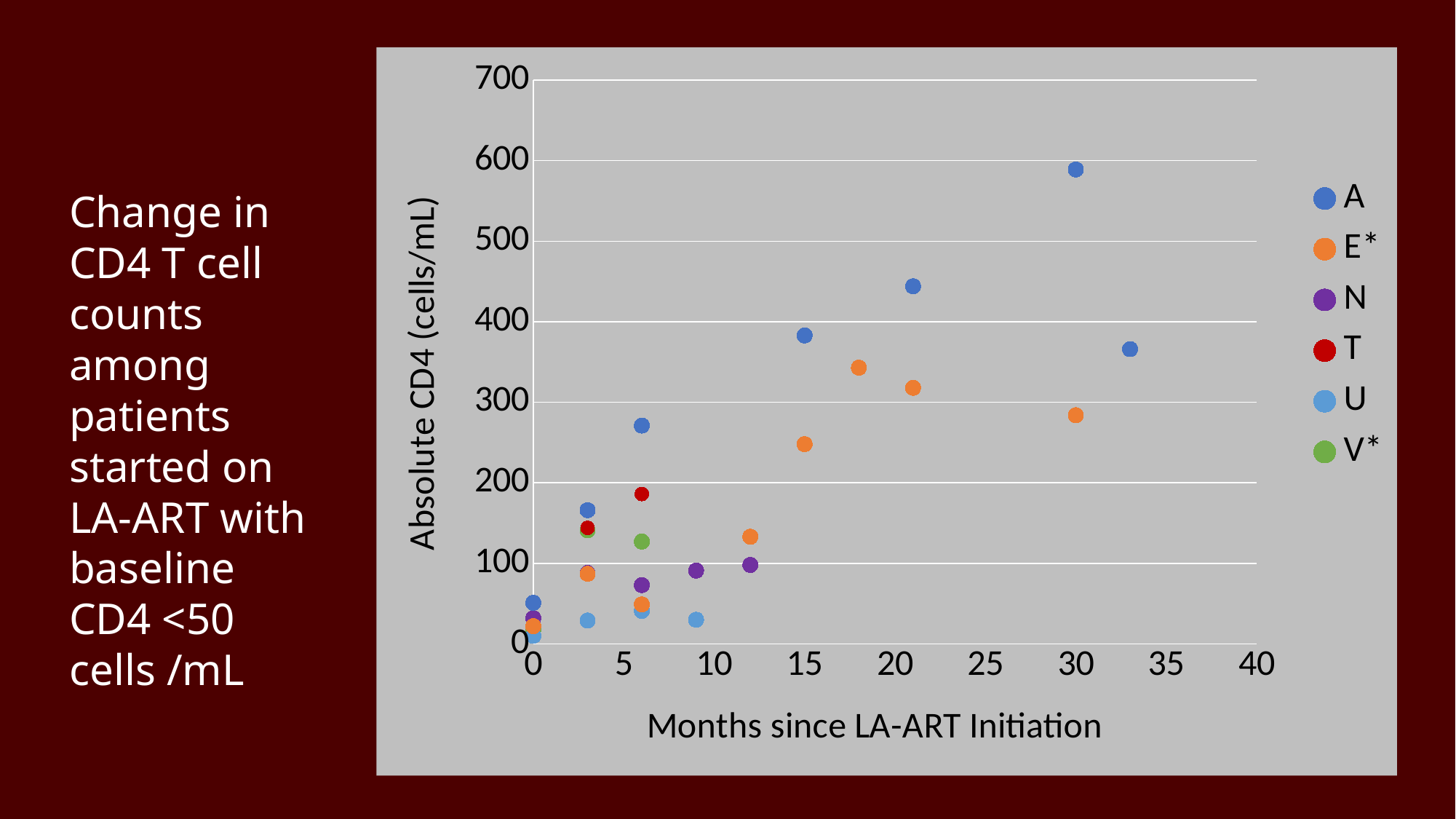
At 6 months, which series has the larger value, T or N? T Is the value for series U at 9 months greater or less than 100? less What kind of chart is shown on the slide? scatter chart Which series has the highest point on the chart? A How many series does the legend list? 6 Is the value for series A at 30 months greater or less than 500? greater Is the value for series E* at 18 months greater or less than 300? greater What is the title of the y axis? Absolute CD4 (cells/mL) At 15 months, which series has the larger value, A or E*? A What is the title of the x axis? Months since LA-ART Initiation How many points are plotted for series T? 3